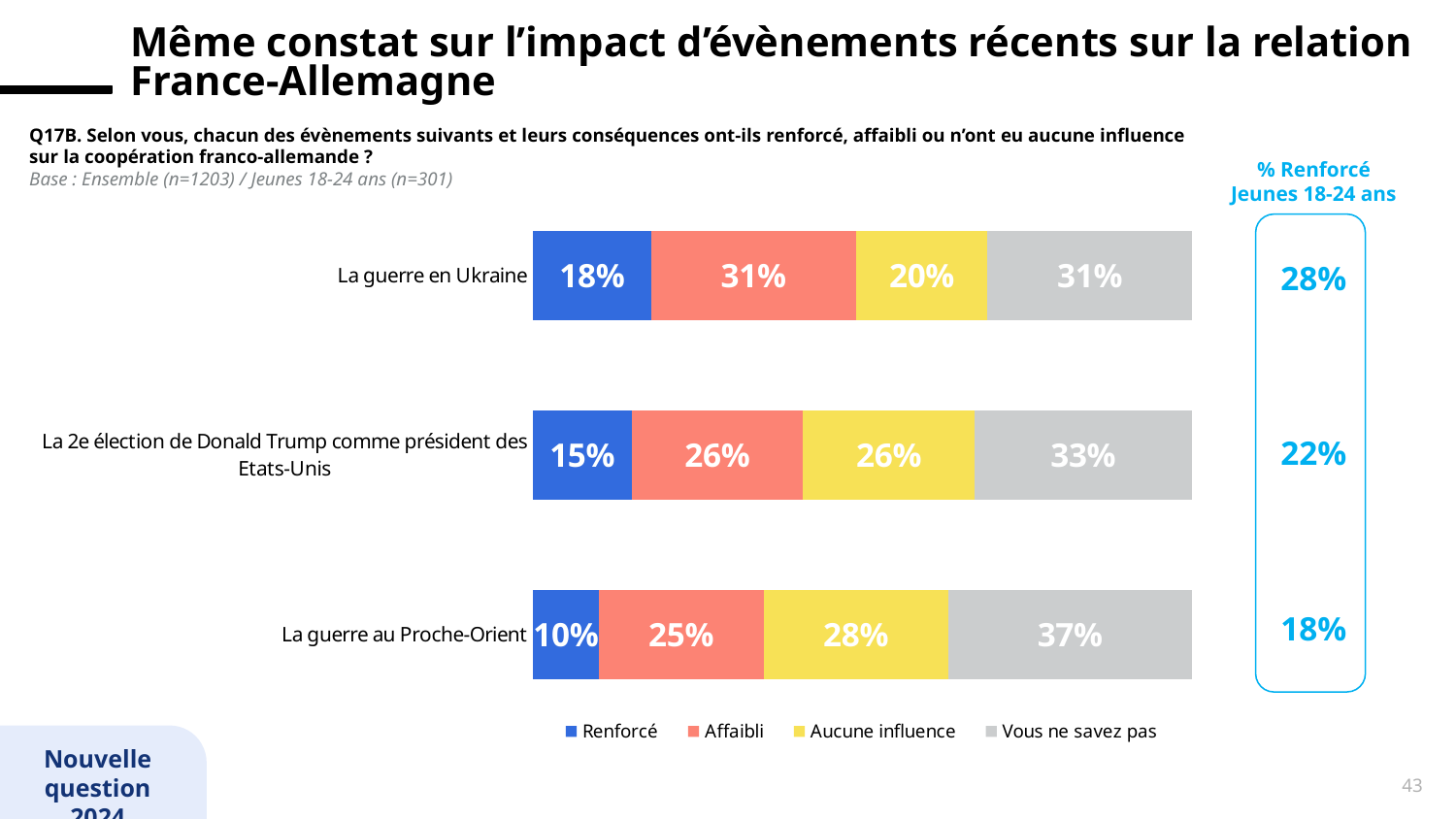
Which event has the highest 'Renforcé' value? La guerre en Ukraine How many series does the legend list? 4 Which event has the lowest 'Affaibli' value? La guerre au Proche-Orient What kind of chart is shown on the slide? stacked bar chart How many categories (events) are plotted in the chart? 3 In the '% Renforcé Jeunes 18-24 ans' column, what is the value for 'La guerre au Proche-Orient'? 18% What is the difference between the 'Aucune influence' values for 'La guerre au Proche-Orient' and 'La guerre en Ukraine'? 8 percentage points What is the 'Renforcé' value for 'La guerre en Ukraine'? 18% What is the 'Vous ne savez pas' value for 'La guerre au Proche-Orient'? 37% What is the 'Affaibli' value for 'La 2e élection de Donald Trump comme président des Etats-Unis'? 26% Which is larger: the 'Vous ne savez pas' value for 'La guerre en Ukraine' or for 'La 2e élection de Donald Trump comme président des Etats-Unis'? La 2e élection de Donald Trump comme président des Etats-Unis Which colour represents the 'Aucune influence' series in the legend? yellow